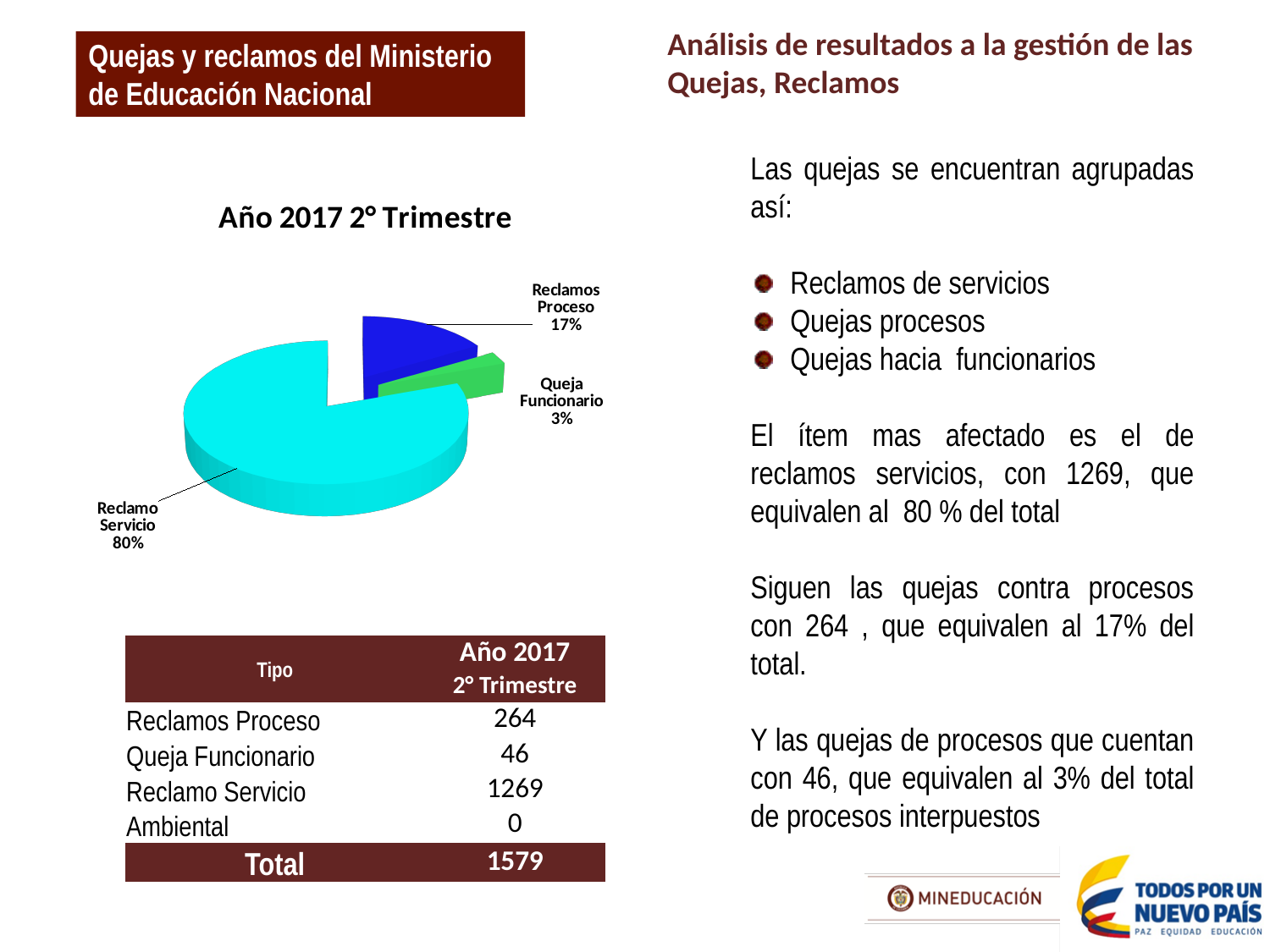
What is the title of the pie chart? Año 2017 2° Trimestre What share of the pie does Queja Funcionario represent? 3% Which is larger in the pie chart, Reclamos Proceso or Queja Funcionario? Reclamos Proceso Which slice of the pie chart is the largest? Reclamo Servicio How many slices are labelled in the pie chart? 3 What is the difference in percentage points between the Reclamos Proceso slice and the Queja Funcionario slice? 14 What share of the pie does Reclamos Proceso represent? 17% What colour is the Reclamo Servicio slice in the pie chart? Cyan Which slice of the pie chart is the smallest? Queja Funcionario What share of the pie does Reclamo Servicio represent? 80% What type of chart is shown on the slide? Pie chart What is the difference in percentage points between the Reclamo Servicio slice and the Reclamos Proceso slice? 63